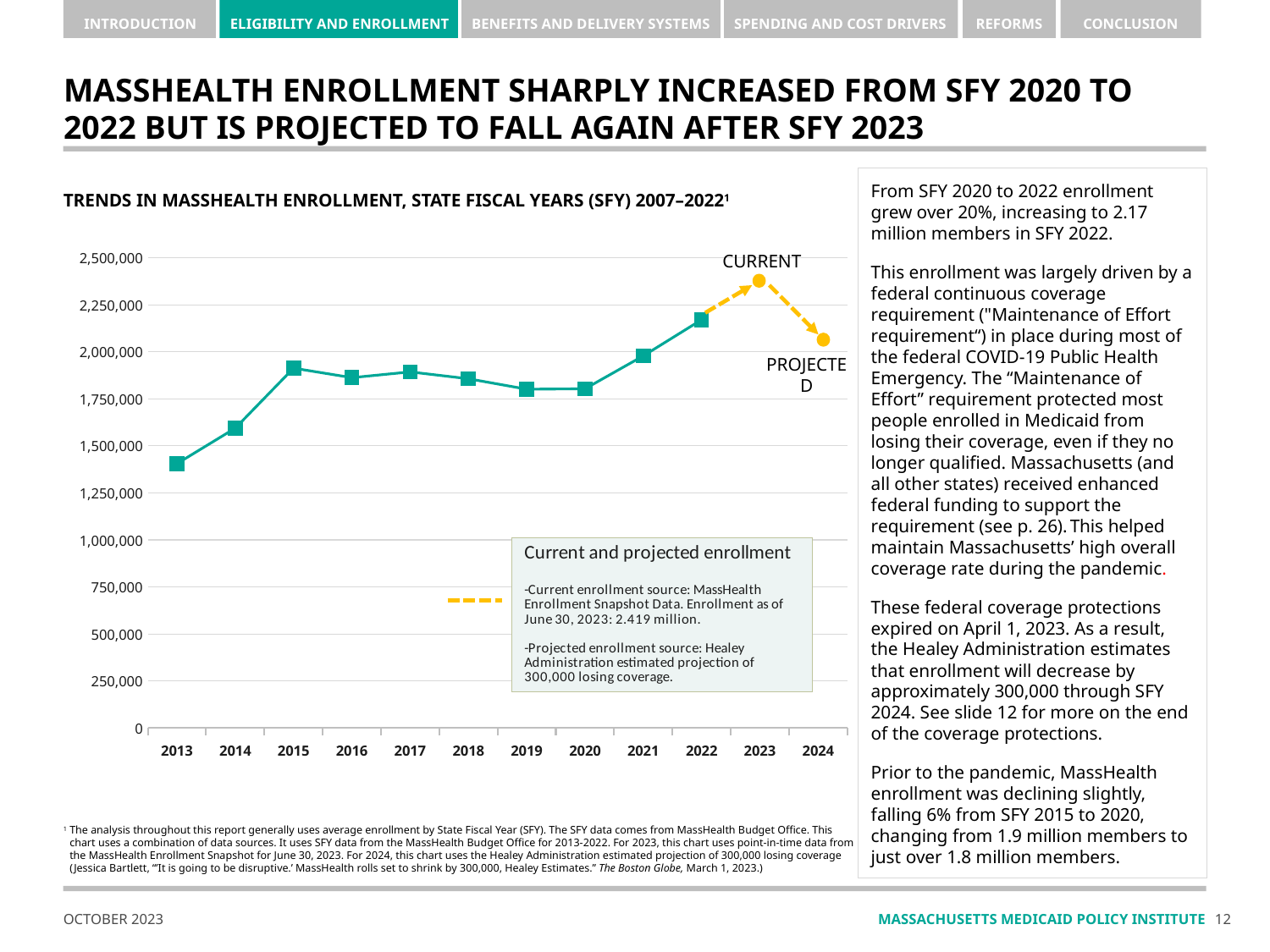
Does enrollment rise or fall from 2013 to 2015? rise Is the enrollment value for 2013 greater or less than 1,500,000? less Which year has the larger enrollment value, 2013 or 2022? 2022 What is the title of the chart? Trends in MassHealth Enrollment, State Fiscal Years (SFY) 2007–2022 What kind of chart is shown on the slide? line chart Which year has the highest enrollment value on the chart? 2023 Does enrollment rise or fall from 2023 to 2024? fall Which year has the lowest enrollment value on the chart? 2013 Is the enrollment value for 2015 greater or less than 2,000,000? less Is the enrollment value for 2022 greater or less than 2,000,000? greater How many years are shown along the x axis of the chart? 12